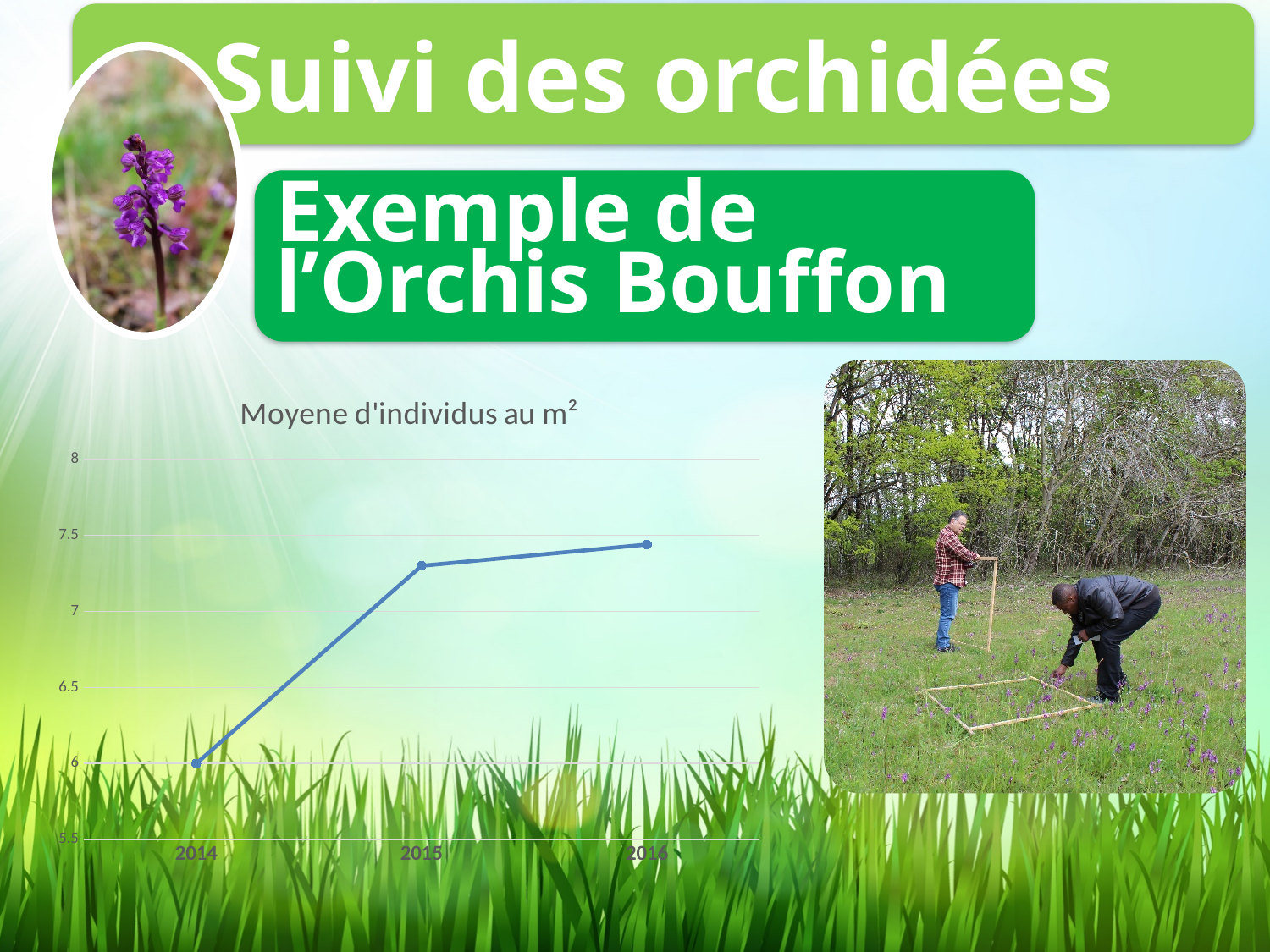
Is the value for 2015 greater or less than 7.5? less What kind of chart is shown on the slide? line chart What is the title of the chart? Moyene d'individus au m² Which is larger, the value for 2014 or the value for 2015? 2015 Which year has the highest value in the chart? 2016 Is the value for 2015 greater or less than 7? greater Do the values rise or fall from 2014 to 2016? rise How many years are plotted on the x axis of the chart? 3 What is the value for 2014 in the chart? 6 Is the value for 2014 greater or less than 6.5? less Which year has the lowest value in the chart? 2014